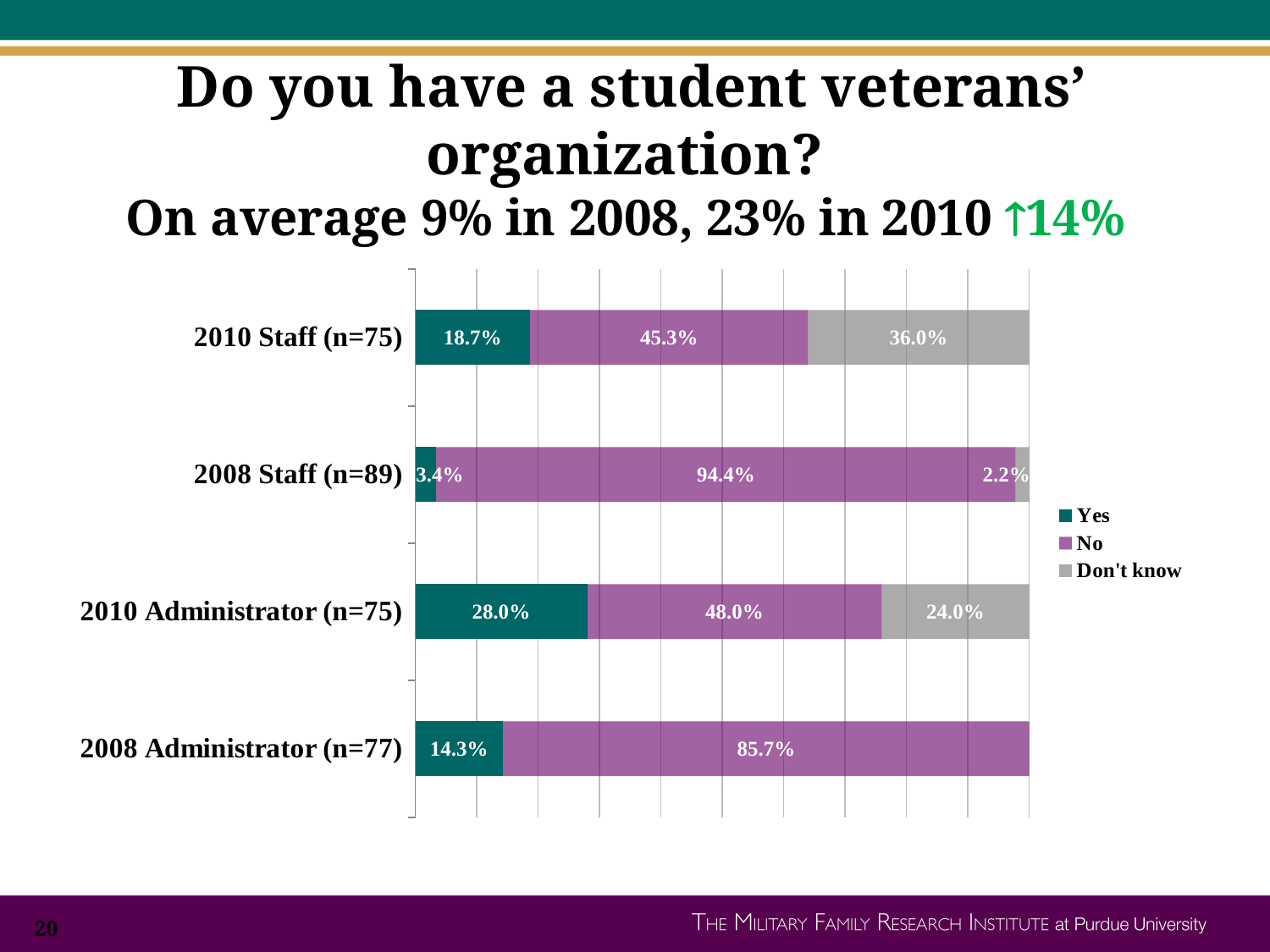
How many series does the legend list? 3 Which group has the highest Yes percentage? 2010 Administrator (n=75) How many groups are shown on the chart? 4 Which group has the lowest Yes percentage? 2008 Staff (n=89) Which is larger: the Don't know percentage for 2010 Staff (n=75) or for 2010 Administrator (n=75)? 2010 Staff (n=75) What percentage of 2008 Staff (n=89) answered No? 94.4% What kind of chart is shown on the slide? Stacked bar chart Which colour represents the No responses in the chart? Purple What percentage of 2010 Staff (n=75) answered Yes? 18.7% What is the difference between the Yes percentage for 2010 Administrator (n=75) and 2008 Administrator (n=77)? 13.7% What percentage of 2010 Administrator (n=75) answered Don't know? 24.0% What percentage of 2008 Administrator (n=77) answered No? 85.7%